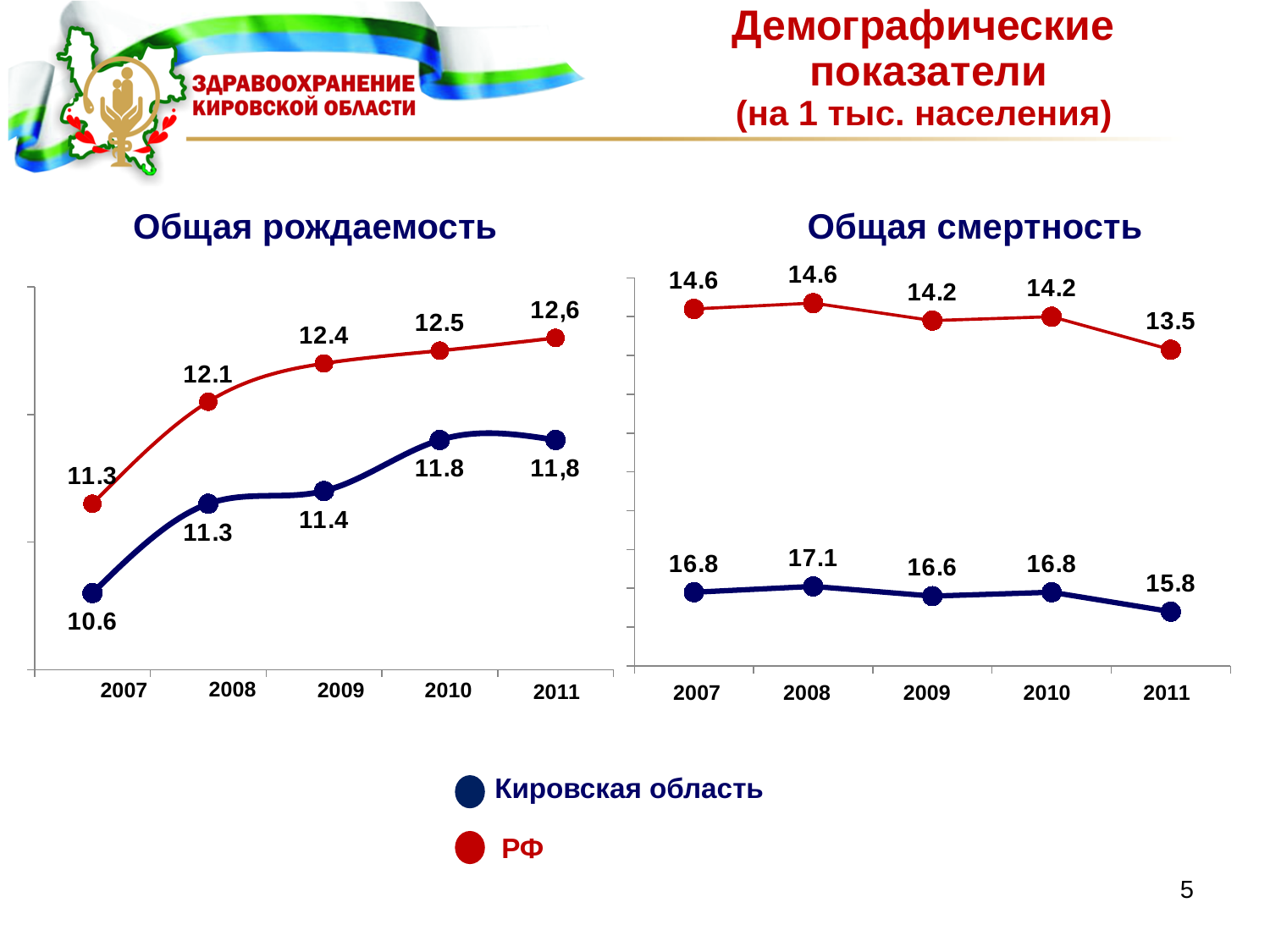
How many series does the legend list? 2 How many years are shown on the x axis of the 'Общая рождаемость' chart? 5 On the 'Общая рождаемость' chart, in which year is the РФ value lowest? 2007 On the 'Общая рождаемость' chart, what is the value for РФ in 2009? 12.4 On the 'Общая смертность' chart, which series has the larger value in 2011, Кировская область or РФ? Кировская область On the 'Общая смертность' chart, in which year is the Кировская область value highest? 2008 On the 'Общая рождаемость' chart, what is the value for Кировская область in 2007? 10.6 On the 'Общая рождаемость' chart, does the РФ series rise or fall from 2007 to 2011? rise What kind of chart is 'Общая смертность'? line chart On the 'Общая рождаемость' chart, what is the difference between the РФ and Кировская область values in 2008? 0.8 On the 'Общая смертность' chart, what is the value for Кировская область in 2008? 17.1 On the 'Общая смертность' chart, what is the value for РФ in 2011? 13.5